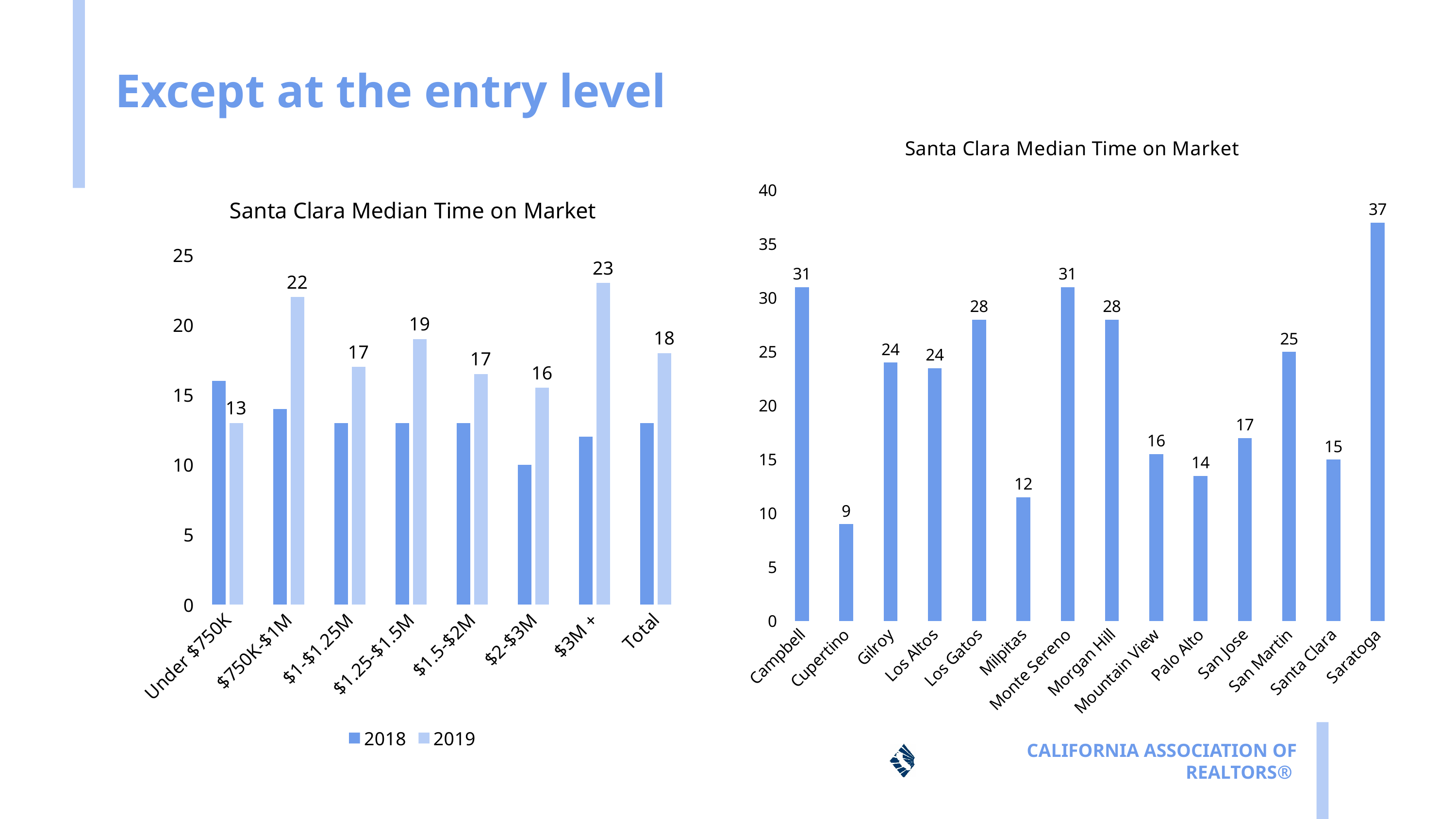
In the left chart, is the 2018 value for Under $750K greater or less than 15? greater In the right chart, which city has the highest median time on market? Saratoga In the right chart, how many cities are shown? 14 In the left chart, is the 2018 value for $2-$3M greater or less than 15? less In the right chart, which city has the lowest median time on market? Cupertino In the right chart, what is the value for Cupertino? 9 In the left chart, which price range has the highest 2019 value? $3M + In the right chart, which is larger, the value for Los Gatos or the value for San Martin? Los Gatos In the left chart, what is the difference between the 2019 values for $3M + and Under $750K? 10 In the left chart, what is the 2019 value for Total? 18 In the left chart, how many series does the legend list? 2 In the left chart, what is the 2019 value for $750K-$1M? 22